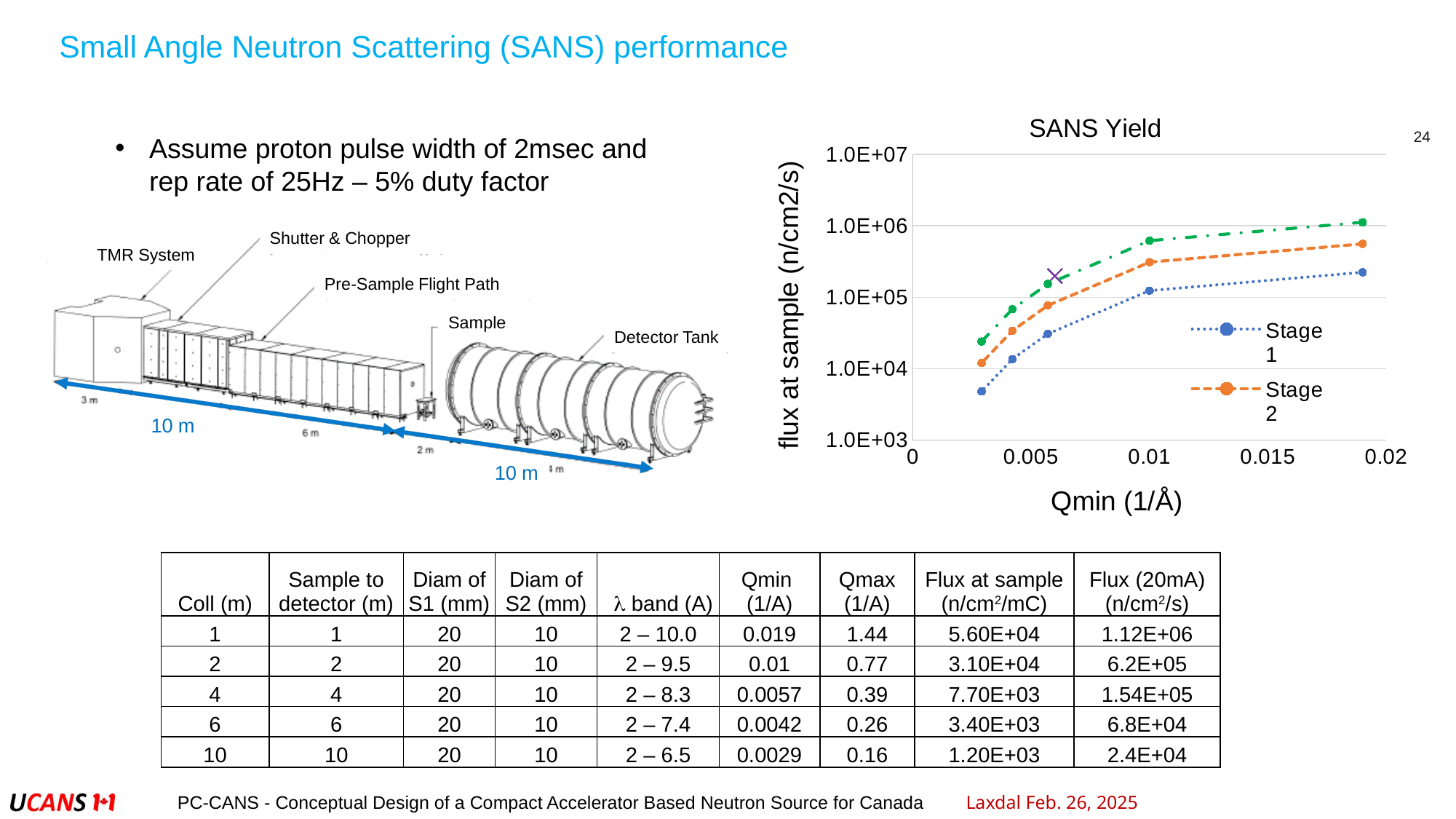
What is the x-axis label of the SANS Yield chart? Qmin (1/Å) In the SANS Yield chart, which of the two legend series has the lower flux at every Qmin value? Stage 1 How many data points are plotted for Stage 1 in the SANS Yield chart? 5 In the SANS Yield chart, is the Stage 1 value at Qmin = 0.01 greater or less than 1.0E+05? greater In the SANS Yield chart, is the lowest Stage 1 value greater or less than 1.0E+04? less In the SANS Yield chart, does the flux at sample rise or fall as Qmin increases? rise In the SANS Yield chart, which series is higher at Qmin = 0.01: Stage 1 or Stage 2? Stage 2 How many series does the legend of the SANS Yield chart list? 2 In the SANS Yield chart, is the Stage 2 value at Qmin = 0.01 greater or less than 1.0E+06? less What is the title of the chart on the slide? SANS Yield What kind of chart is the SANS Yield chart? line chart